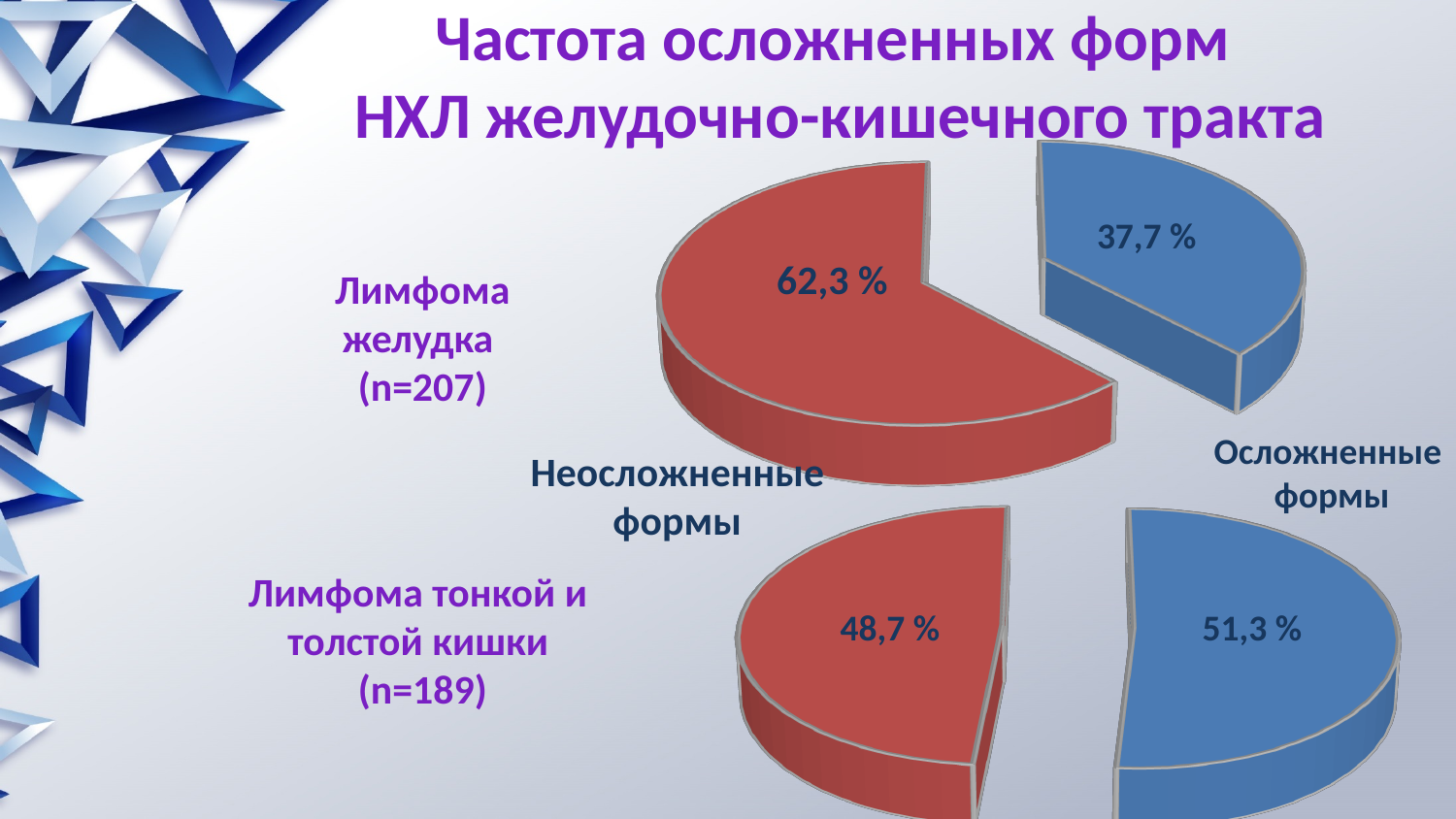
In the pie chart for Лимфома тонкой и толстой кишки (n=189), what is the difference in percentage points between Осложненные формы and Неосложненные формы? 2,6 How many slices does the pie chart for Лимфома желудка (n=207) have? 2 In the pie chart for Лимфома желудка (n=207), what share is labelled for Осложненные формы? 37,7 % In the pie chart for Лимфома желудка (n=207), which slice is the largest? Неосложненные формы In the pie chart for Лимфома тонкой и толстой кишки (n=189), which slice is the smallest? Неосложненные формы In the pie chart for Лимфома тонкой и толстой кишки (n=189), what share is labelled for Неосложненные формы? 48,7 % In the pie chart for Лимфома желудка (n=207), what is the difference in percentage points between Неосложненные формы and Осложненные формы? 24,6 What type of chart is used on this slide? Pie chart In the pie chart for Лимфома желудка (n=207), what share is labelled for Неосложненные формы? 62,3 % In the pie chart for Лимфома тонкой и толстой кишки (n=189), what share is labelled for Осложненные формы? 51,3 % Which is larger: the share of Осложненные формы for Лимфома желудка (n=207) or for Лимфома тонкой и толстой кишки (n=189)? Лимфома тонкой и толстой кишки (n=189) What colour represents Осложненные формы in the pie charts? Blue